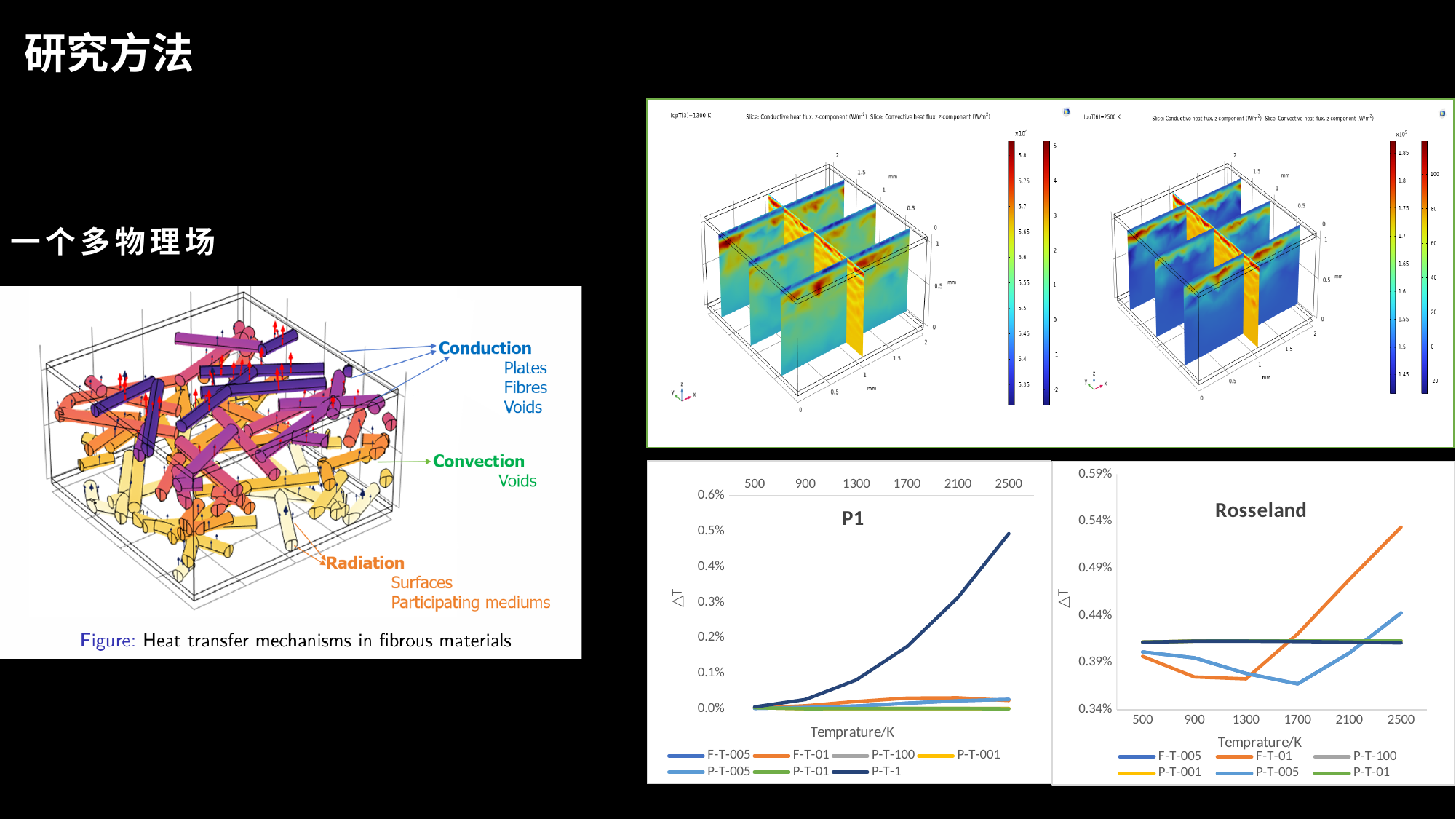
In the Rosseland chart, is the value of F-T-01 at 2500 K greater or less than 0.49%? greater In the P1 chart, which series has the highest value at 2500 K? P-T-1 What kind of chart is the P1 chart? line chart How many series does the legend of the Rosseland chart list? 6 In the Rosseland chart, which is larger at 2500 K: F-T-01 or P-T-005? F-T-01 What is the x-axis title of the P1 chart? Temprature/K In the P1 chart, does the P-T-1 series rise or fall as temperature increases from 500 K to 2500 K? rise How many series does the legend of the P1 chart list? 7 In the P1 chart, is the value of P-T-1 at 2500 K greater or less than 0.4%? greater What is the title of the line chart on the right side of the slide? Rosseland In the Rosseland chart, is the value of P-T-005 at 1700 K greater or less than 0.39%? less How many temperature values are shown on the x axis of the Rosseland chart? 6